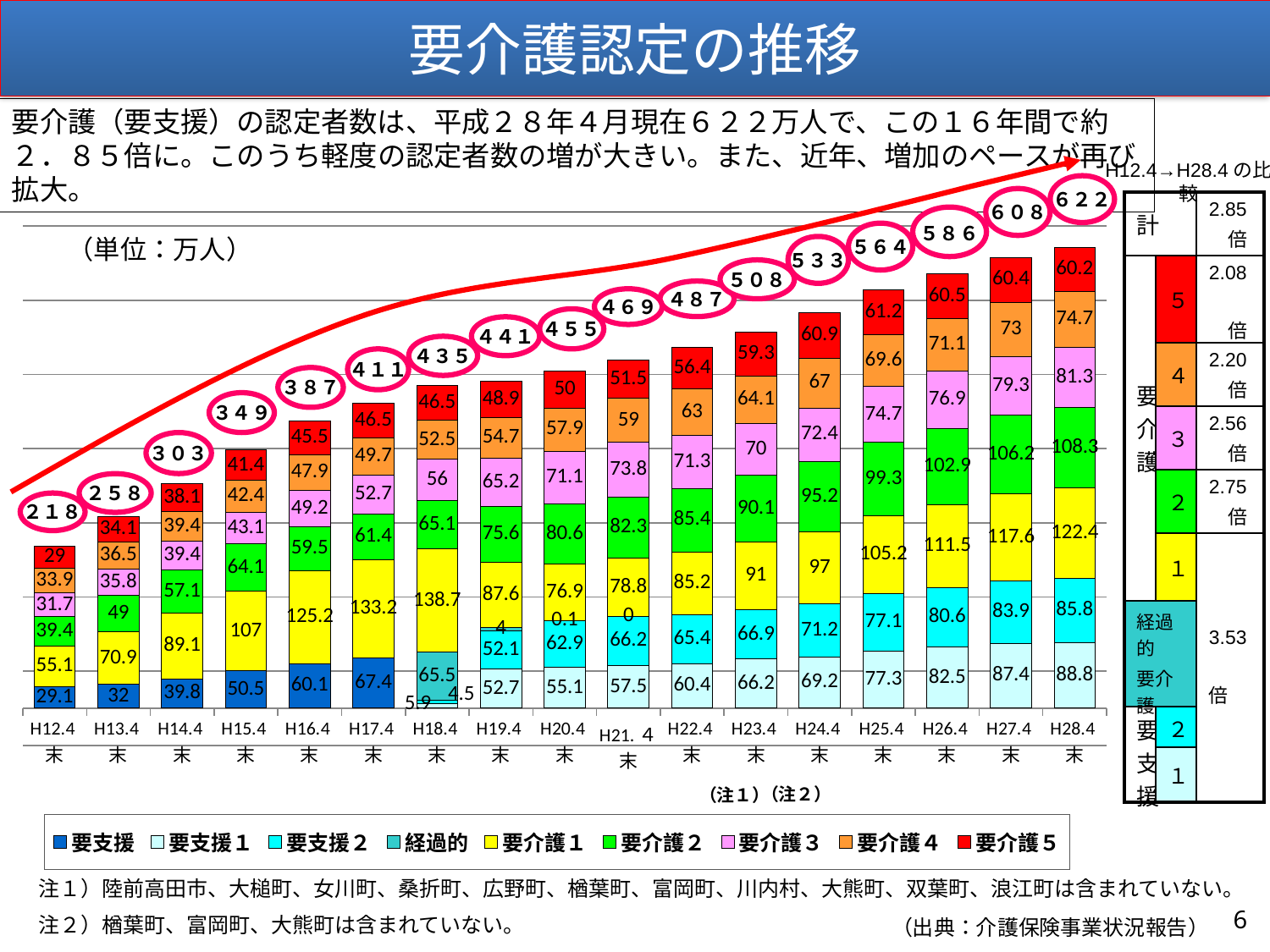
What kind of chart is shown on the slide? Stacked bar chart What is the value of 要介護5 for H12.4末? 29 Which period has the highest total? H28.4末 Do the totals rise or fall from H12.4末 to H28.4末? Rise What is the circled total for H12.4末? 218 What is the value of 要介護5 for H28.4末? 60.2 What is the circled total for H28.4末? 622 By how much does the circled total for H28.4末 exceed the circled total for H12.4末? 404 How many series does the legend list? 9 How many time periods (bars) are plotted along the x axis? 17 In H28.4末, which is larger, 要介護1 or 要介護2? 要介護1 What is the value of 要介護1 for H28.4末? 122.4